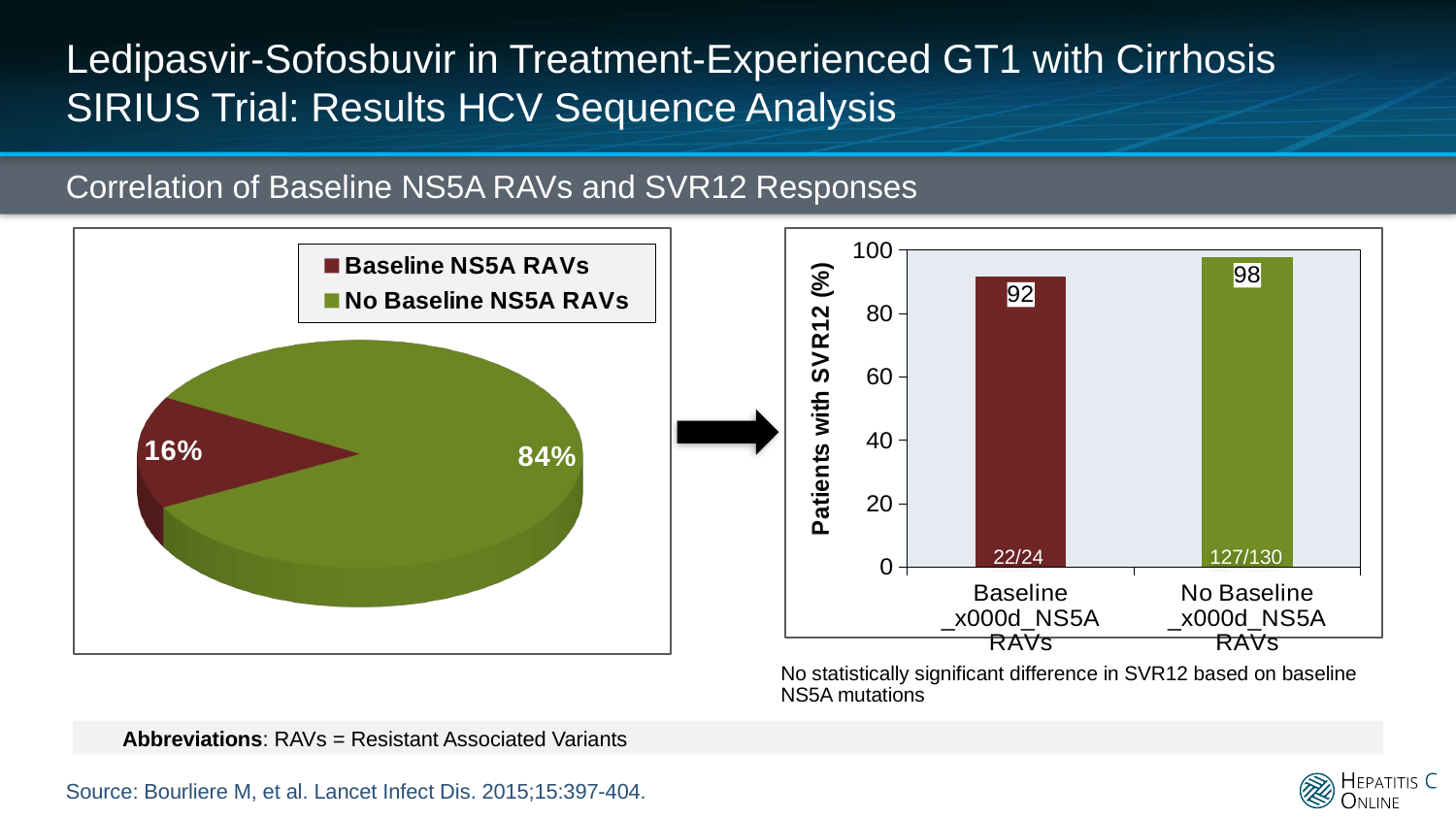
In the pie chart on the left, which slice is larger: Baseline NS5A RAVs or No Baseline NS5A RAVs? No Baseline NS5A RAVs In the pie chart on the left, what share of patients had Baseline NS5A RAVs? 16% In the pie chart on the left, how many slices are there? 2 What kind of chart is shown on the right side of the slide? Bar chart What kind of chart is shown on the left side of the slide? Pie chart In the bar chart on the right, what is the SVR12 percentage for patients with No Baseline NS5A RAVs? 98 In the bar chart on the right, what is the difference in SVR12 percentage between the No Baseline NS5A RAVs group and the Baseline NS5A RAVs group? 6 In the pie chart on the left, how many entries does the legend list? 2 In the bar chart on the right, what is the SVR12 percentage for patients with Baseline NS5A RAVs? 92 In the bar chart on the right, which group has the higher SVR12 percentage? No Baseline NS5A RAVs In the bar chart on the right, what is the y-axis label? Patients with SVR12 (%) In the pie chart on the left, what share of patients had No Baseline NS5A RAVs? 84%